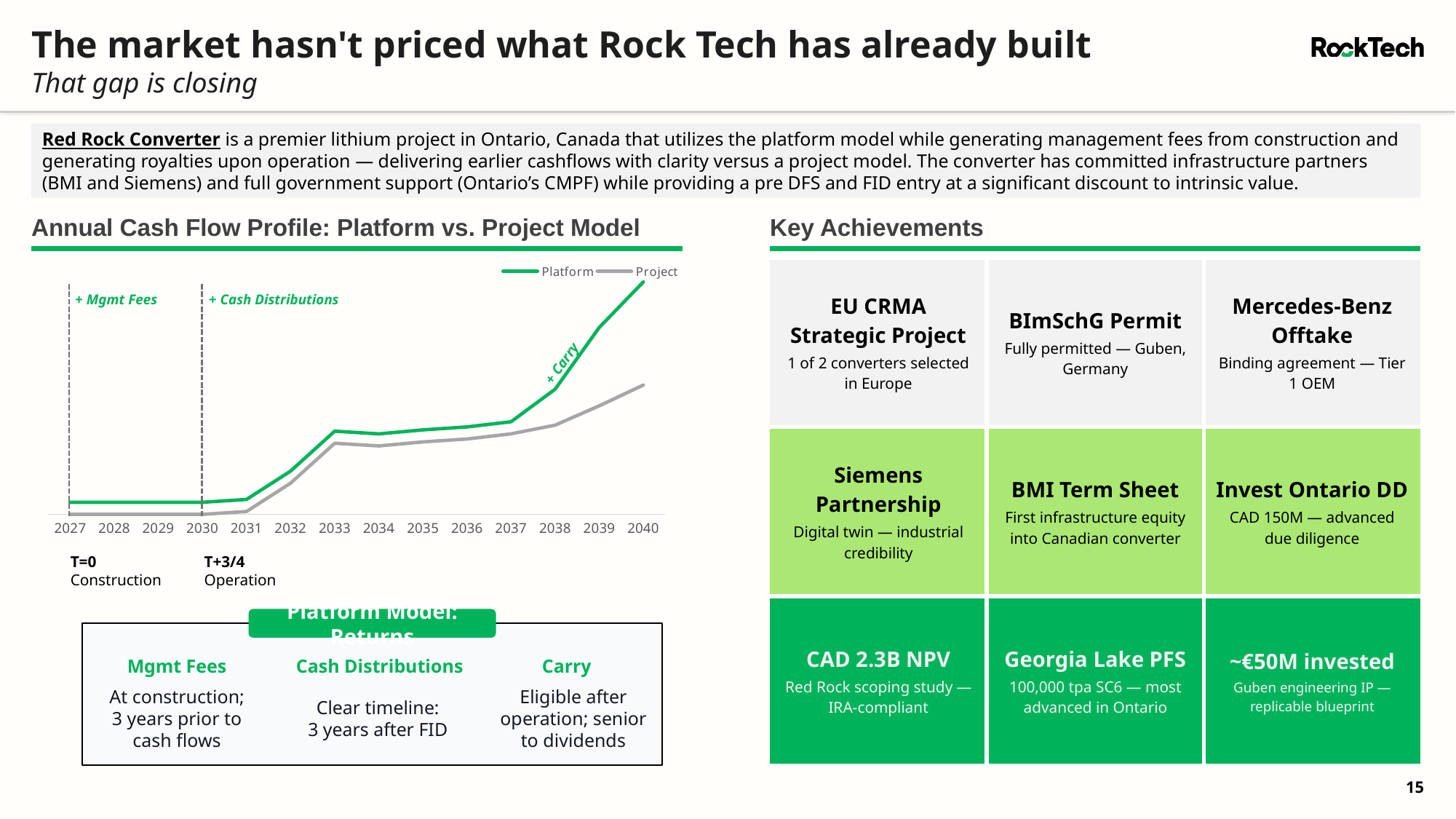
In 2038, which series is higher in the Annual Cash Flow Profile chart, Platform or Project? Platform In which year does the Platform series reach its highest value in the Annual Cash Flow Profile chart? 2040 In 2040, which series is higher in the Annual Cash Flow Profile chart, Platform or Project? Platform What kind of chart is the Annual Cash Flow Profile chart? Line chart In which year does the Project series reach its highest value in the Annual Cash Flow Profile chart? 2040 How many years are shown on the x axis of the Annual Cash Flow Profile chart? 14 Does the Project series rise or fall between 2031 and 2033 in the Annual Cash Flow Profile chart? Rise Is the Platform series rising, falling or flat between 2027 and 2030 in the Annual Cash Flow Profile chart? Flat What are the two series named in the legend of the Annual Cash Flow Profile chart? Platform and Project What is the first year shown on the x axis of the Annual Cash Flow Profile chart? 2027 Does the Platform series rise or fall between 2037 and 2040 in the Annual Cash Flow Profile chart? Rise How many series does the legend of the Annual Cash Flow Profile chart list? 2